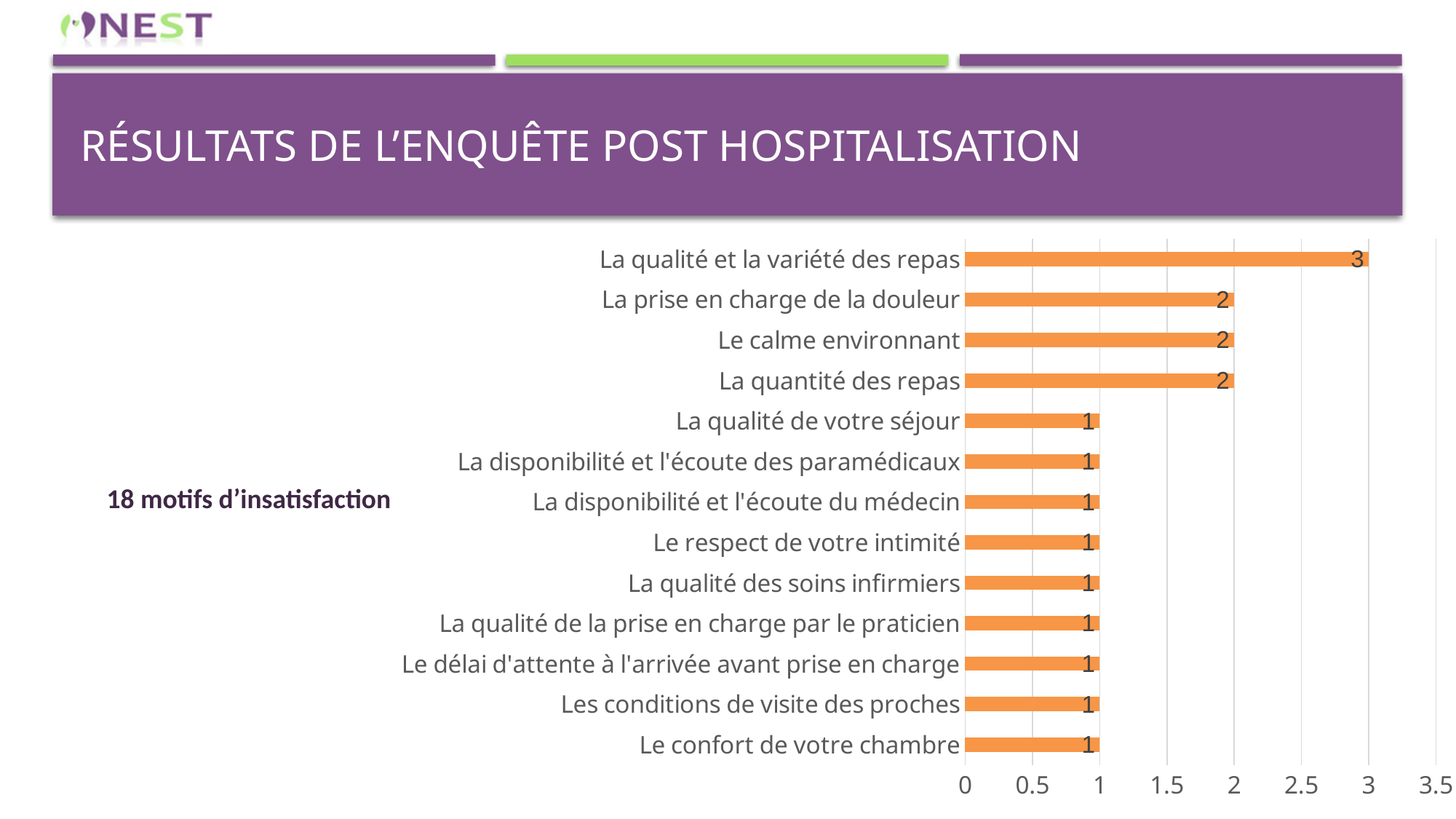
Is the value for "La qualité et la variété des repas" greater or less than 2.5? greater What value is shown for "Le confort de votre chambre"? 1 What value is shown for "La prise en charge de la douleur"? 2 Which category has the highest value? La qualité et la variété des repas What kind of chart is shown on the slide? bar chart How many categories are shown in the chart? 13 What value is shown for "La qualité et la variété des repas"? 3 Which is larger, the value for "La prise en charge de la douleur" or the value for "La qualité de votre séjour"? La prise en charge de la douleur What value is shown for "Le calme environnant"? 2 What is the difference between the values for "La qualité et la variété des repas" and "La quantité des repas"? 1 What is the maximum value shown on the horizontal axis? 3.5 How many categories have a value of 1? 9